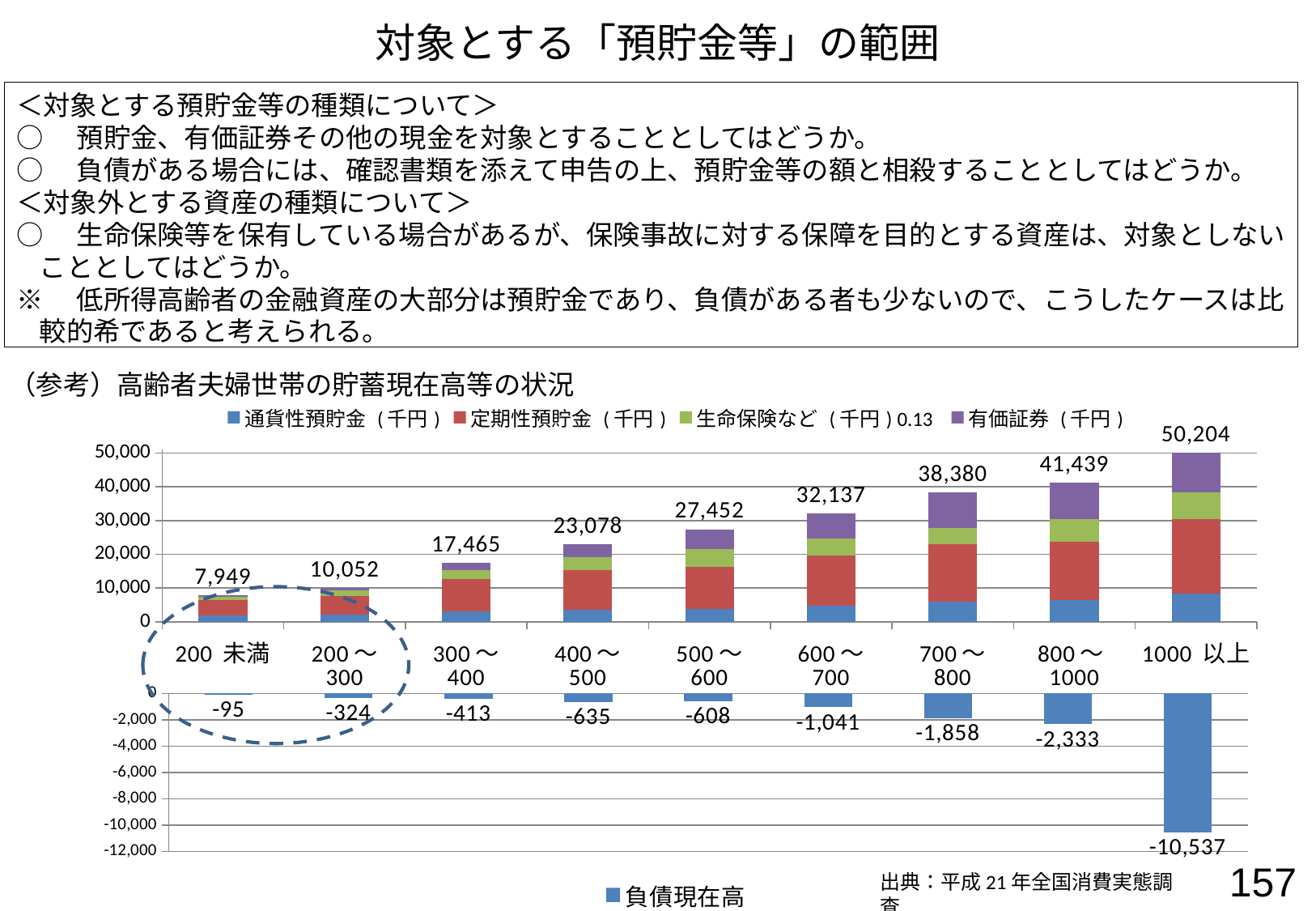
What kind of chart is the lower chart (負債現在高)? bar chart How many categories are shown on the x axis of the upper stacked bar chart? 9 In the lower chart (負債現在高), what is the value for the 1000 以上 category? -10,537 In the upper stacked bar chart, which category has the lowest total? 200 未満 In the upper stacked bar chart, what is the total labeled for the 200 未満 category? 7,949 How many series does the legend of the upper stacked bar chart list? 4 In the lower chart (負債現在高), what is the value for the 600～700 category? -1,041 In the upper stacked bar chart, what is the difference between the totals for 800～1000 and 700～800? 3,059 In the upper stacked bar chart, do the totals rise or fall as you move from 200 未満 to 1000 以上? rise In the upper stacked bar chart, which series is shown in purple according to the legend? 有価証券（千円） In the lower chart (負債現在高), which of 400～500 and 500～600 has the larger (less negative) value? 500～600 In the upper stacked bar chart, what is the total labeled for the 1000 以上 category? 50,204